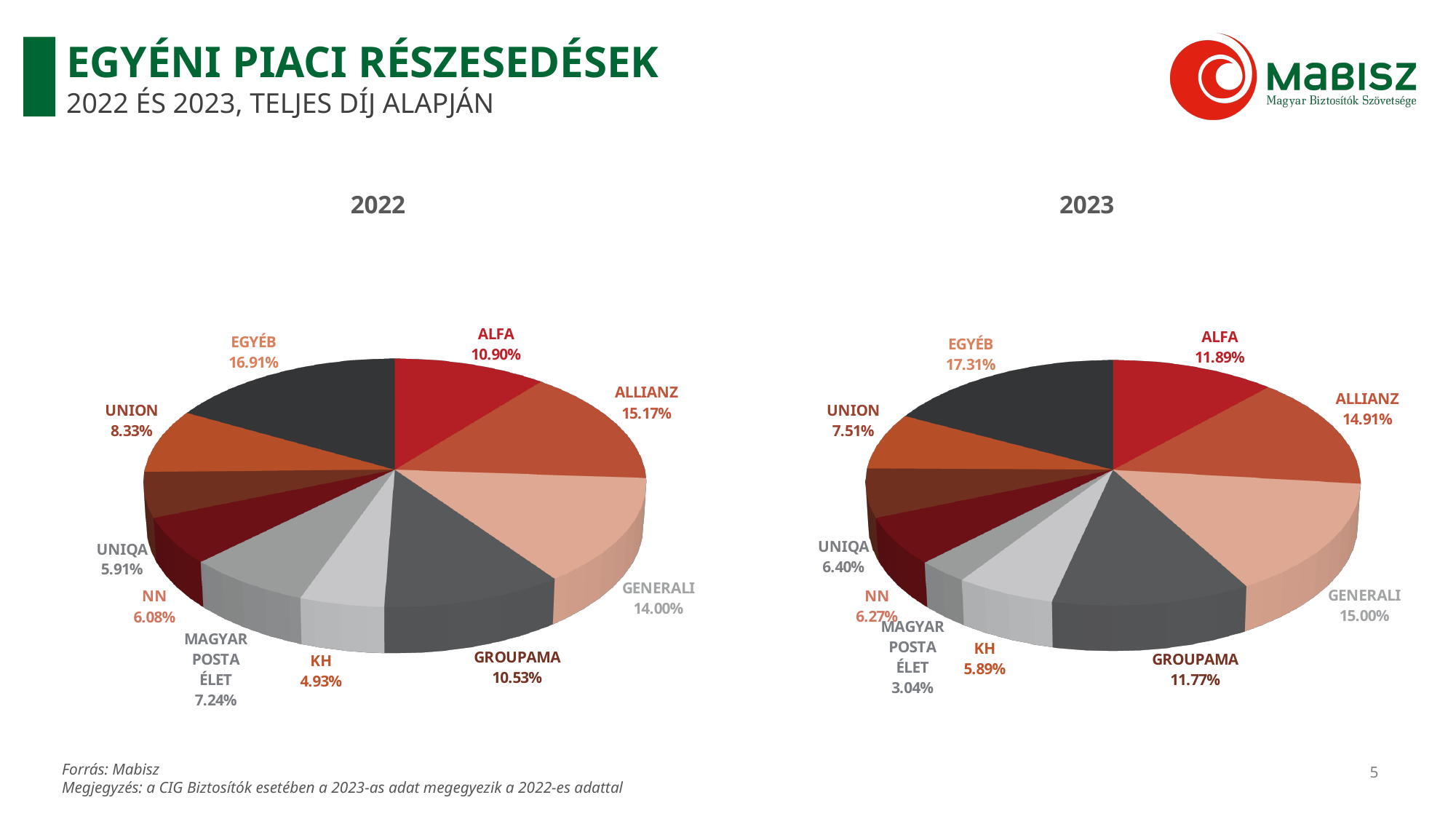
In the 2023 pie chart, what is the share for MAGYAR POSTA ÉLET? 3.04% In the 2022 pie chart, what is the difference between the shares of ALLIANZ and GENERALI? 1.17% In the 2022 pie chart, which category has the largest share? EGYÉB In the 2023 pie chart, what is the share for GROUPAMA? 11.77% In the 2022 pie chart, what is the share for ALLIANZ? 15.17% In the 2023 pie chart, which category has the largest share? EGYÉB In the 2022 pie chart, which category has the smallest share? KH In the 2023 pie chart, which category has the smallest share? MAGYAR POSTA ÉLET In the 2023 pie chart, which is larger, the share for ALFA or the share for UNION? ALFA What is the title of the chart on the left side of the slide? 2022 What type of chart is used for the 2023 data? Pie chart How many slices does the 2022 pie chart have? 10